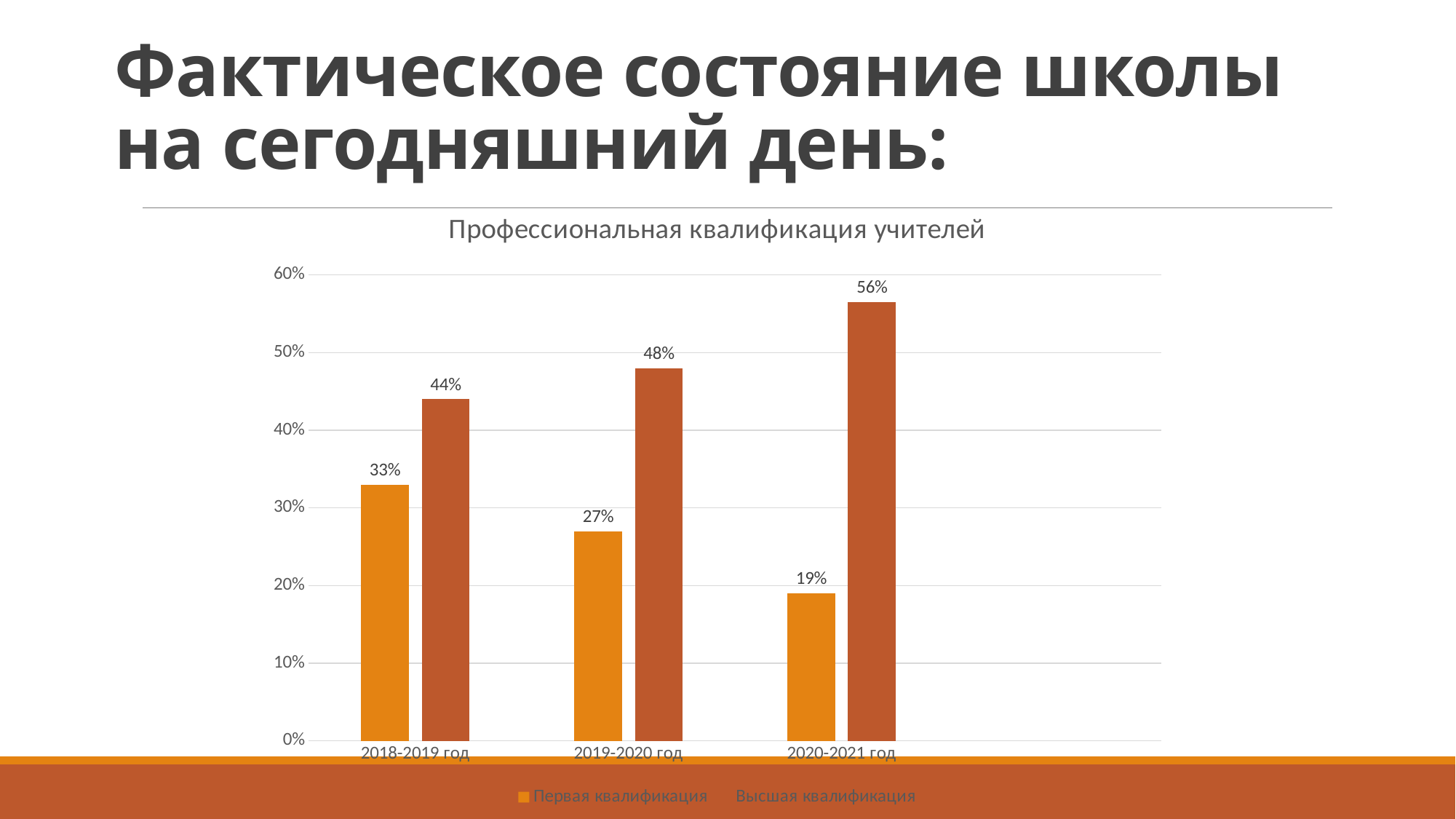
What kind of chart is shown? Bar chart What is the value for Высшая квалификация in 2020-2021 год? 56% How many year categories are shown on the x axis? 3 What is the value for Первая квалификация in 2018-2019 год? 33% In which year is Первая квалификация lowest? 2020-2021 год Does Первая квалификация rise or fall from 2018-2019 год to 2020-2021 год? Fall What is the difference between Высшая квалификация and Первая квалификация in 2019-2020 год? 21% What is the value for Первая квалификация in 2020-2021 год? 19% What is the value for Высшая квалификация in 2019-2020 год? 48% In which year is Высшая квалификация highest? 2020-2021 год How many series does the legend list? 2 Which is larger in 2018-2019 год: Первая квалификация or Высшая квалификация? Высшая квалификация